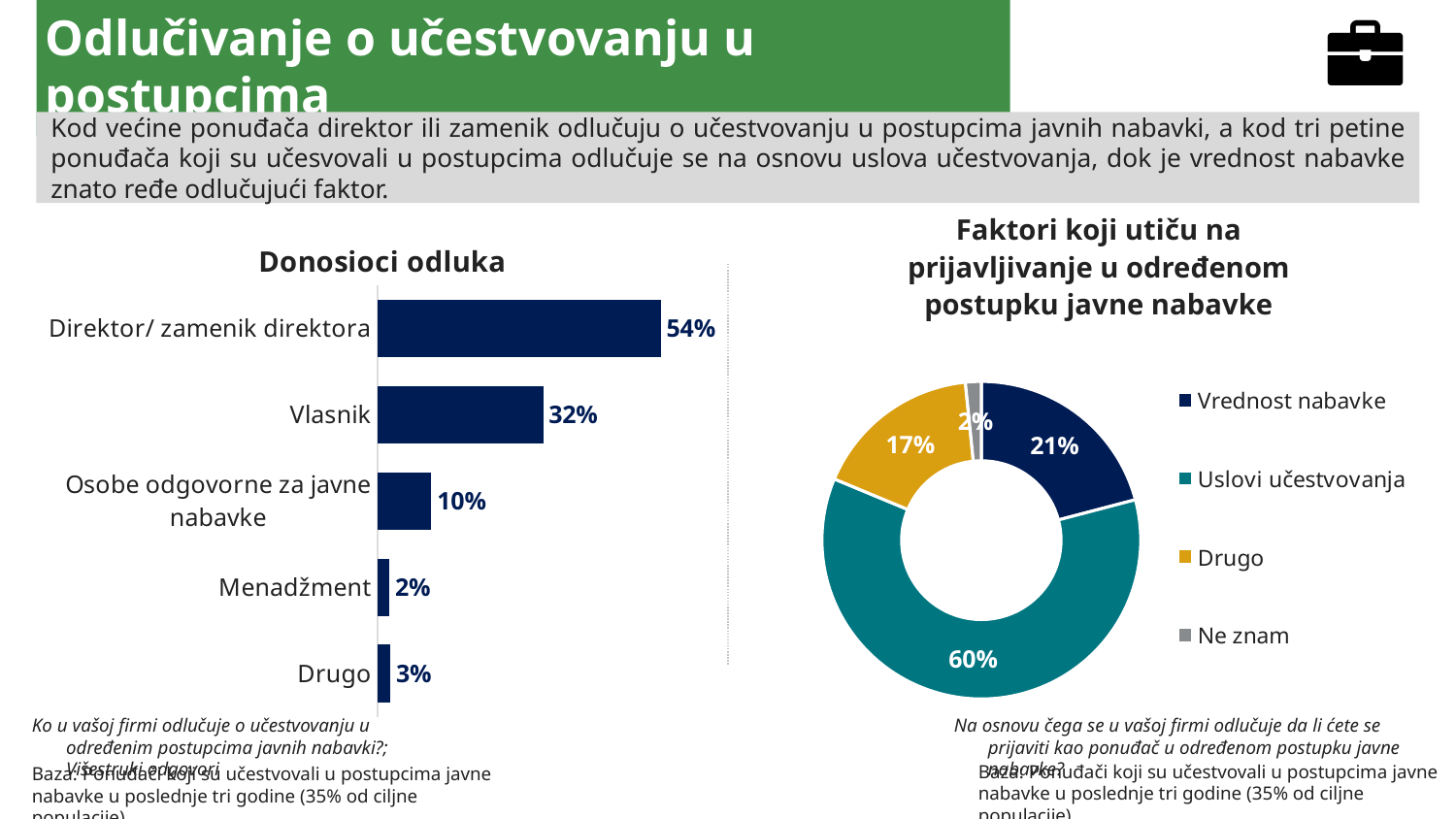
In the 'Donosioci odluka' chart, what is the value for Direktor/ zamenik direktora? 54% What kind of chart is 'Donosioci odluka'? Bar chart In the 'Donosioci odluka' chart, what is the value for Vlasnik? 32% In the 'Faktori koji utiču na prijavljivanje u određenom postupku javne nabavke' chart, what is the share for Uslovi učestvovanja? 60% In the 'Donosioci odluka' chart, what is the difference between Direktor/ zamenik direktora and Vlasnik? 22% In the 'Donosioci odluka' chart, which category has the lowest value? Menadžment In the 'Donosioci odluka' chart, how many categories are shown? 5 What kind of chart is 'Faktori koji utiču na prijavljivanje u određenom postupku javne nabavke'? Donut chart In the 'Donosioci odluka' chart, which category has the highest value? Direktor/ zamenik direktora In the 'Faktori koji utiču na prijavljivanje u određenom postupku javne nabavke' chart, what is the share for Vrednost nabavke? 21% In the 'Faktori koji utiču na prijavljivanje u određenom postupku javne nabavke' chart, which is larger: Drugo or Vrednost nabavke? Vrednost nabavke How many entries does the legend of the 'Faktori koji utiču na prijavljivanje u određenom postupku javne nabavke' chart list? 4